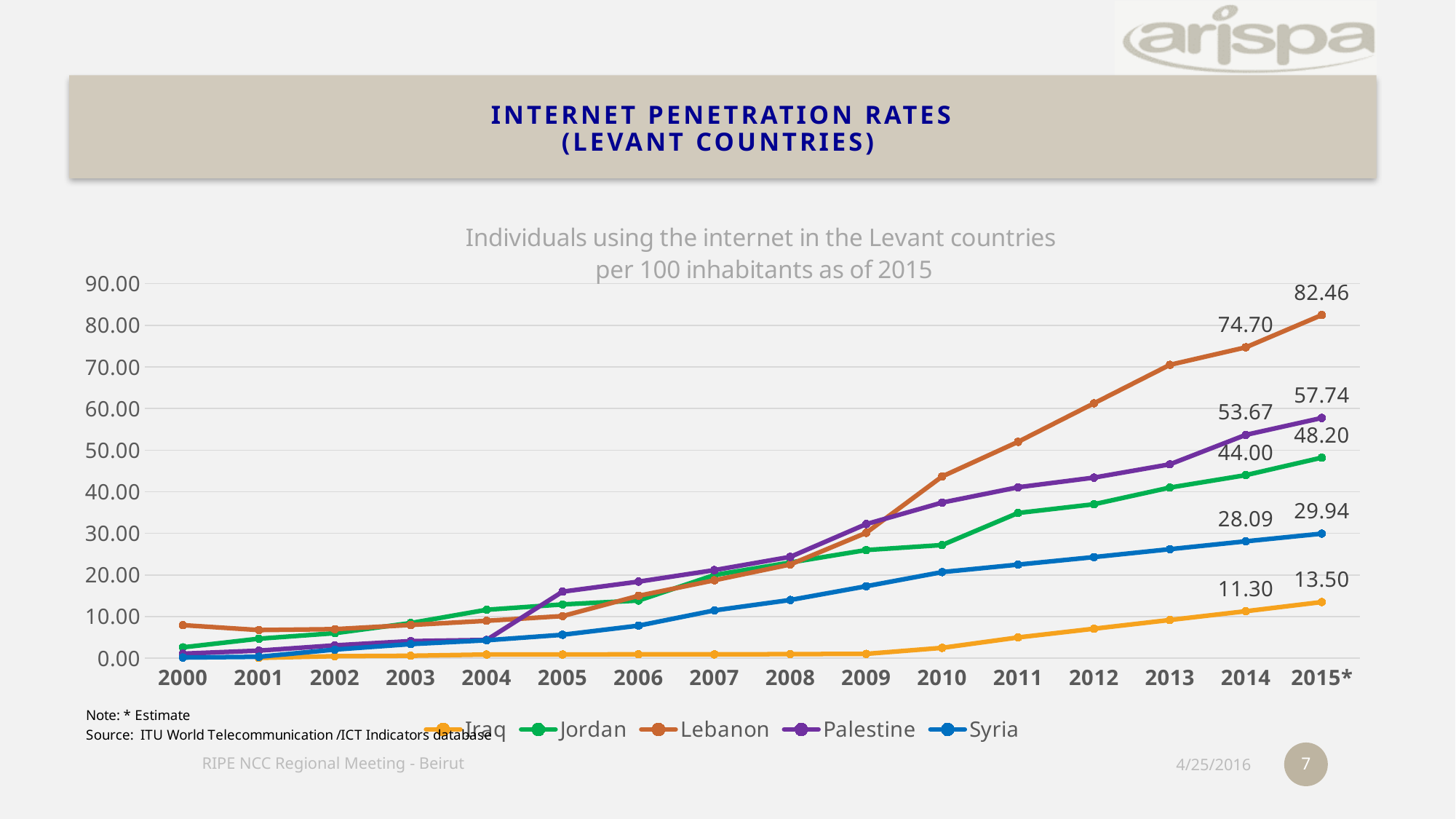
Which country has the highest value in 2015*? Lebanon Which country has the lowest value in 2015*? Iraq How many years are shown on the x axis? 16 How many series does the legend list? 5 What is the value for Palestine in 2014? 53.67 What is the value for Iraq in 2015*? 13.50 What is the difference between Lebanon's 2015* value and its 2014 value? 7.76 What type of chart is shown on the slide? line chart Is the value for Lebanon in 2010 greater or less than 40.00? greater What is the value for Lebanon in 2015*? 82.46 Does the value for Lebanon rise or fall from 2005 to 2015*? rise Which is larger in 2014, the value for Jordan or the value for Syria? Jordan